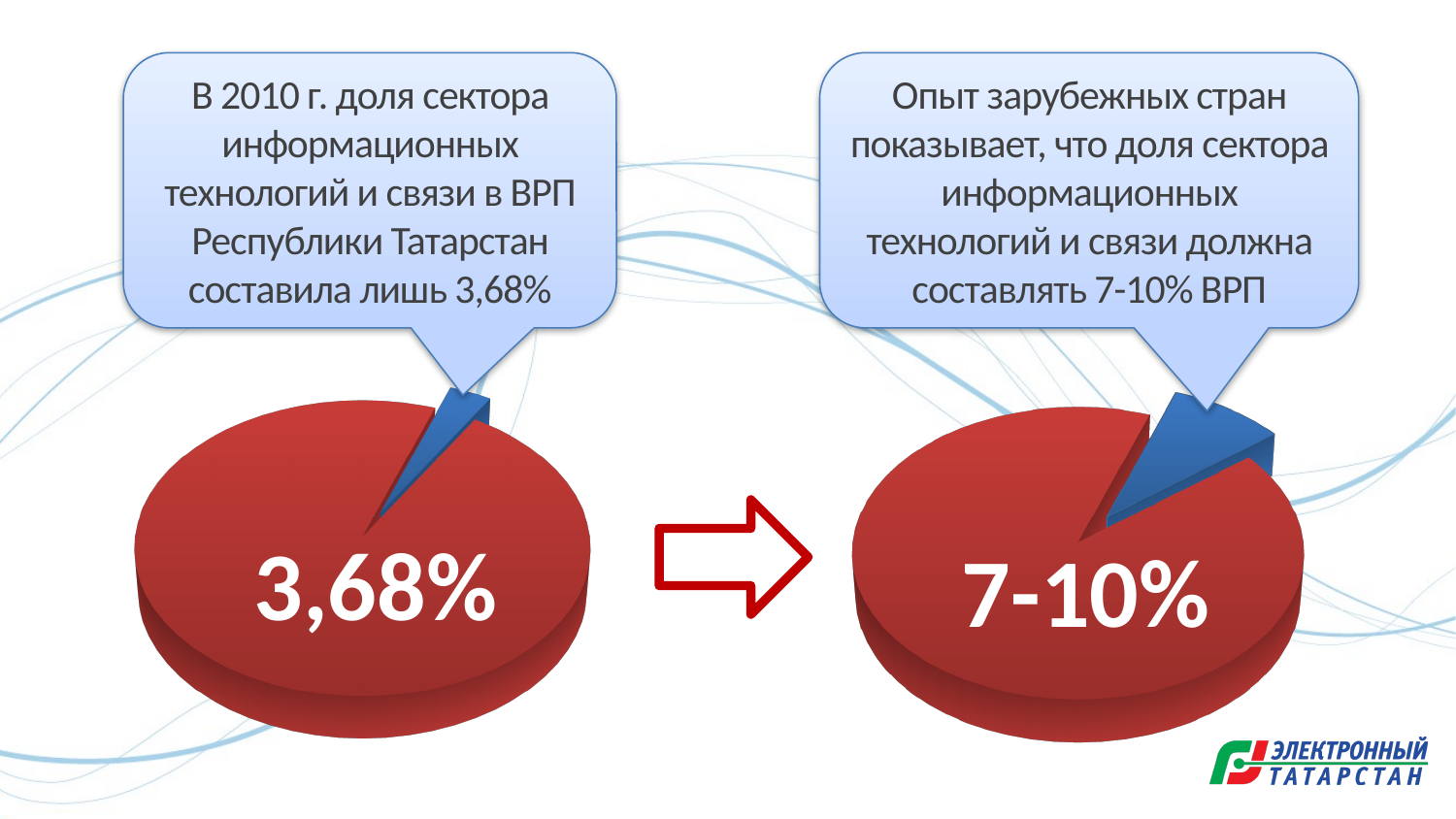
For which year does the left pie chart show the 3,68% share? 2010 In the right pie chart, what share of GRP (ВРП) should the information technology and communications sector make up according to foreign experience? 7-10% What value is printed in the centre of the right pie chart? 7-10% What value is printed in the centre of the left pie chart? 3,68% What colour is the pulled-out slice representing the IT and communications sector in both pie charts? blue How many slices does the left pie chart have? 2 In the left pie chart, is the share of the IT and communications sector greater or less than 5%? less In the left pie chart, what share of GRP (ВРП) did the information technology and communications sector make up in 2010? 3,68% What kind of chart is shown on the right side of the slide? pie chart Which pie chart has the larger blue (pulled-out) slice, the left one or the right one? the right one What kind of chart is shown on the left side of the slide? pie chart How many slices does the right pie chart have? 2